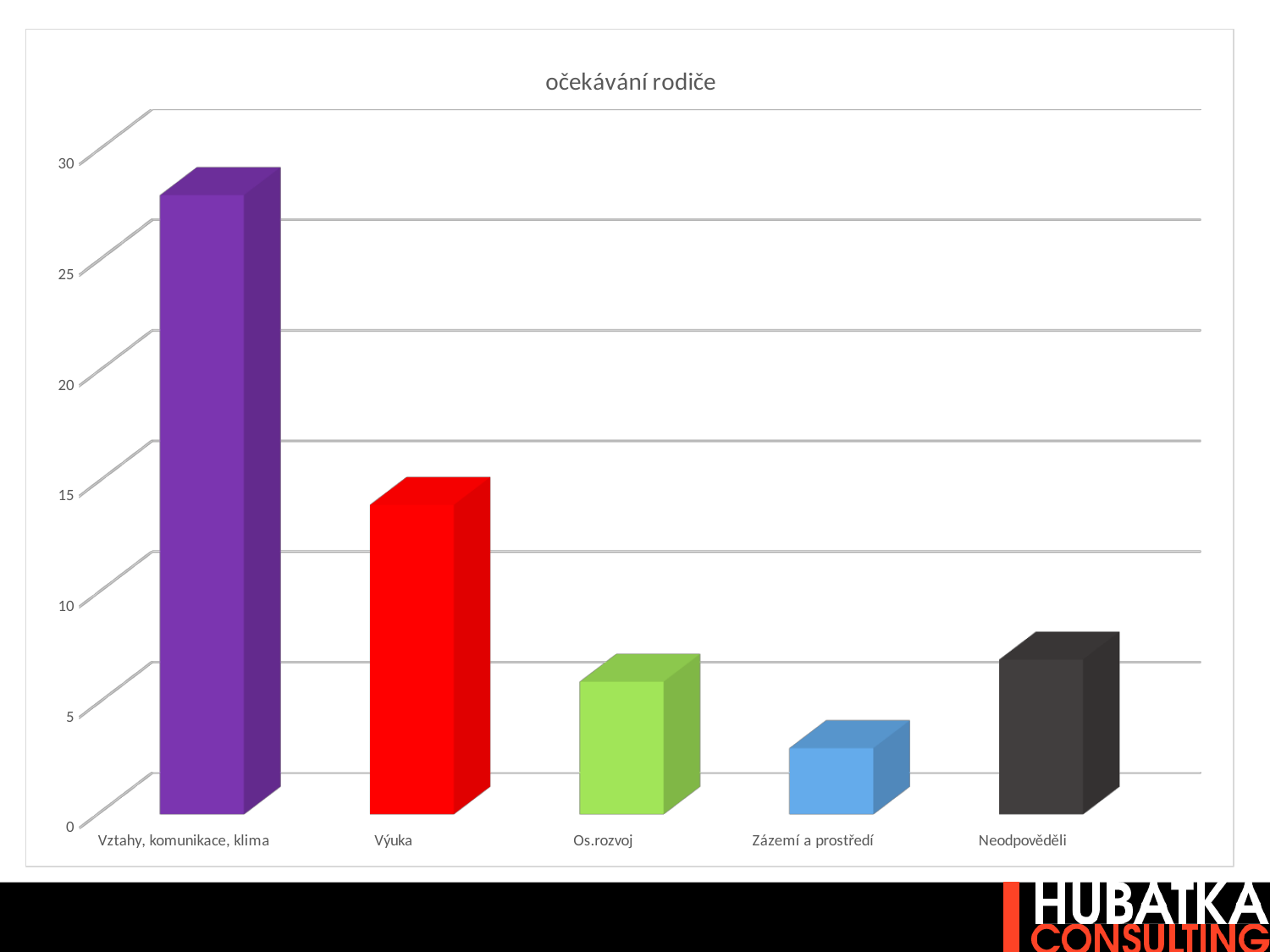
What colour is the bar for Výuka? red Which category has the highest value in the chart? Vztahy, komunikace, klima Is the value for Neodpověděli greater or less than 5? greater What kind of chart is shown on the slide? bar chart Is the value for Vztahy, komunikace, klima greater or less than 25? greater Is the value for Zázemí a prostředí greater or less than 5? less Which category has the lowest value in the chart? Zázemí a prostředí What is the title of the chart? očekávání rodiče How many categories are shown on the x axis of the chart? 5 Which has a larger value, Výuka or Os.rozvoj? Výuka